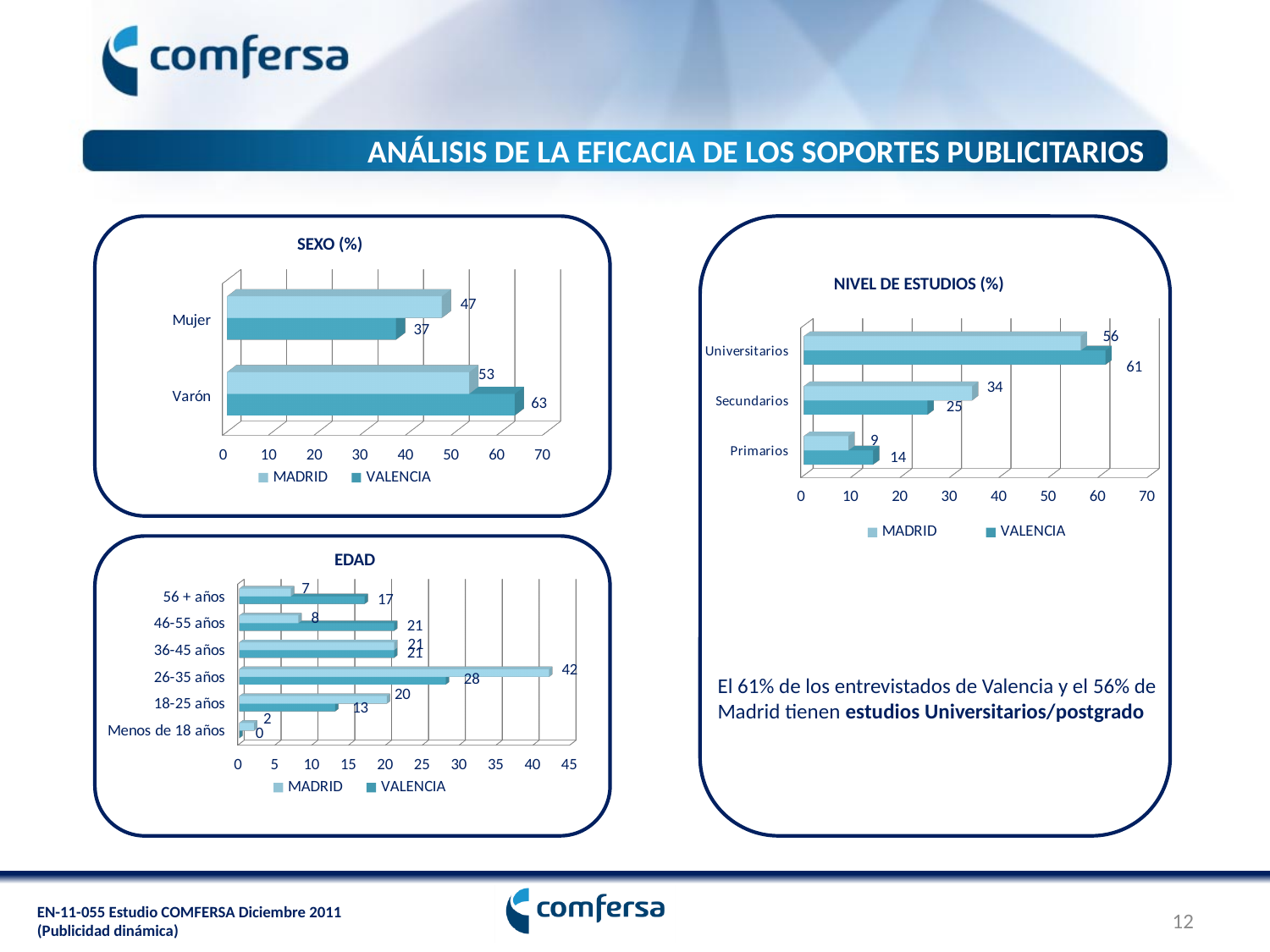
In the EDAD chart, which age group has the highest VALENCIA value? 26-35 años In the EDAD chart, what is the VALENCIA value for Menos de 18 años? 0 How many series does the legend of the NIVEL DE ESTUDIOS (%) chart list? 2 In the SEXO (%) chart, what is the value for Varón in the VALENCIA series? 63 In the EDAD chart, how many age categories are shown? 6 In the NIVEL DE ESTUDIOS (%) chart, what is the difference between the MADRID and VALENCIA values for Secundarios? 9 In the SEXO (%) chart, what is the value for Mujer in the MADRID series? 47 In the NIVEL DE ESTUDIOS (%) chart, what is the VALENCIA value for Universitarios? 61 In the SEXO (%) chart, what is the difference between the VALENCIA and MADRID values for Varón? 10 In the EDAD chart, what is the MADRID value for 26-35 años? 42 In the EDAD chart, which is larger for 18-25 años: the MADRID value or the VALENCIA value? MADRID In the NIVEL DE ESTUDIOS (%) chart, which category has the lowest MADRID value? Primarios